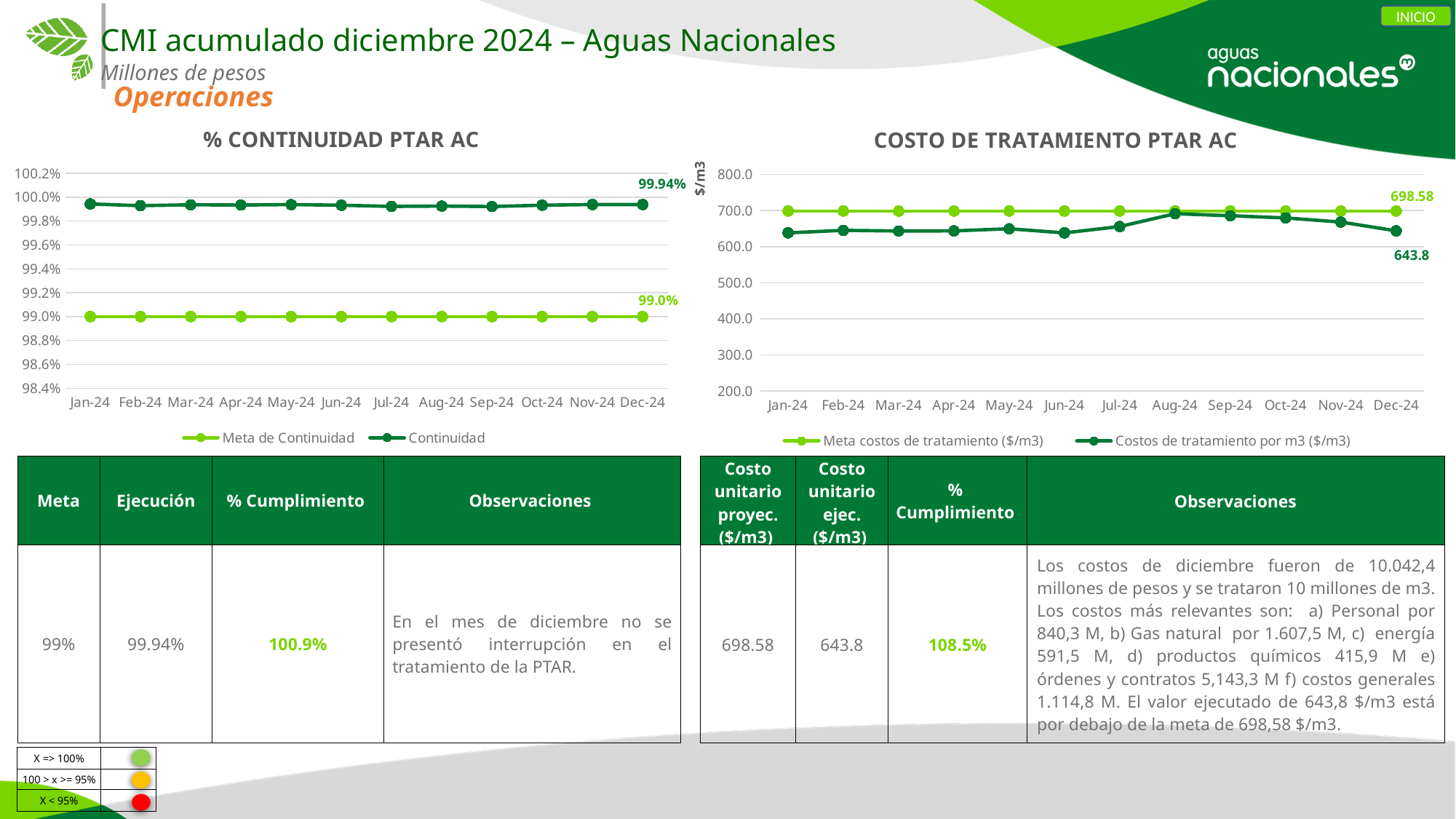
In the COSTO DE TRATAMIENTO PTAR AC chart, what is the difference between the Dec-24 Meta costos de tratamiento and the Dec-24 Costos de tratamiento por m3? 54.78 In the % CONTINUIDAD PTAR AC chart, what is the value of Continuidad for Dec-24? 99.94% In the COSTO DE TRATAMIENTO PTAR AC chart, do the Costos de tratamiento por m3 values rise or fall from Aug-24 to Dec-24? fall In the COSTO DE TRATAMIENTO PTAR AC chart, what is the value of Meta costos de tratamiento ($/m3) for Dec-24? 698.58 In the COSTO DE TRATAMIENTO PTAR AC chart, is the value of Costos de tratamiento por m3 for Jan-24 greater or less than 700.0? less What kind of chart is the COSTO DE TRATAMIENTO PTAR AC chart? Line chart In the COSTO DE TRATAMIENTO PTAR AC chart, which series has the higher value in Dec-24, Meta costos de tratamiento or Costos de tratamiento por m3? Meta costos de tratamiento ($/m3) In the COSTO DE TRATAMIENTO PTAR AC chart, what is the value of Costos de tratamiento por m3 ($/m3) for Dec-24? 643.8 In the % CONTINUIDAD PTAR AC chart, which series has the higher value in Dec-24, Continuidad or Meta de Continuidad? Continuidad In the % CONTINUIDAD PTAR AC chart, what is the value of Meta de Continuidad for Dec-24? 99.0% How many series does the legend of the COSTO DE TRATAMIENTO PTAR AC chart list? 2 How many months are plotted on the x axis of the % CONTINUIDAD PTAR AC chart? 12